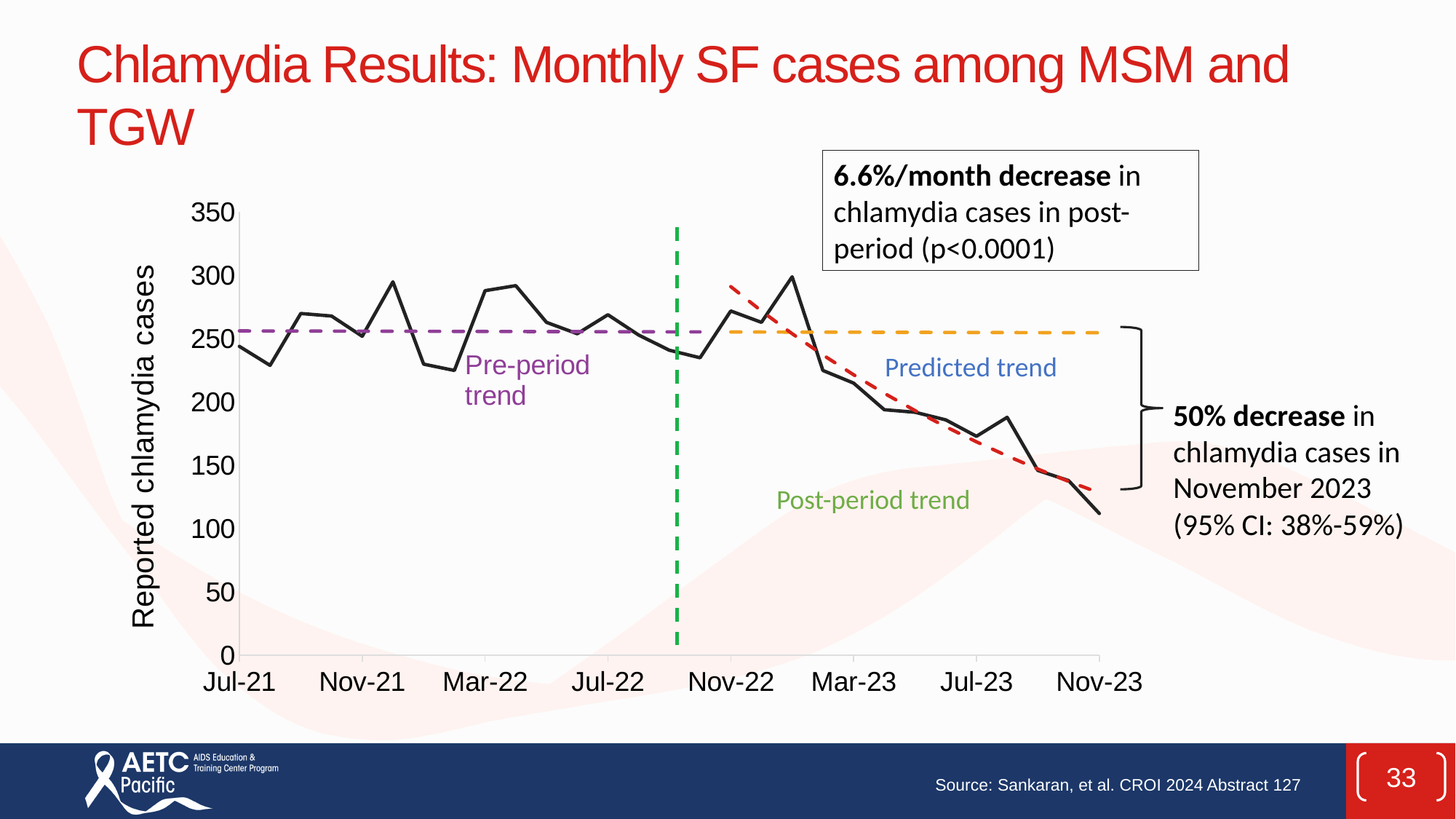
At which labelled month does the line reach its lowest value? Nov-23 Is the value for Jul-23 greater or less than 200? less Is the value for Jul-21 greater or less than 200? greater Is the value for Nov-22 greater or less than 250? greater Do the reported chlamydia cases rise or fall between Nov-22 and Nov-23? fall According to the annotation, what is the monthly percentage decrease in chlamydia cases in the post-period? 6.6%/month What kind of chart is shown on the slide? line chart Which has more reported chlamydia cases, Jul-21 or Nov-23? Jul-21 What is the label of the y axis? Reported chlamydia cases How many month labels are shown on the x axis? 8